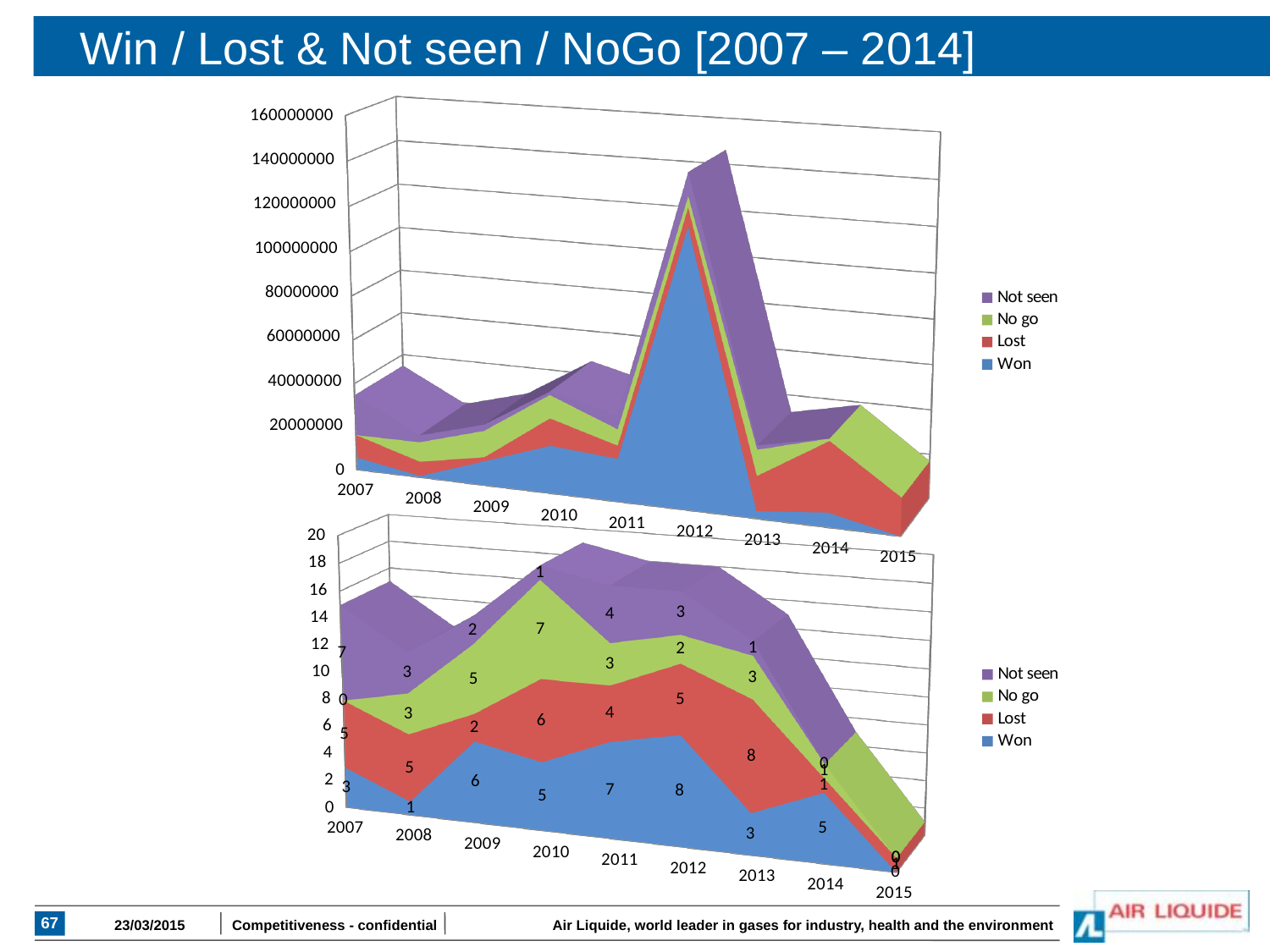
In the bottom chart, what is the value for Lost in 2013? 8 In the bottom chart, what is the value for Won in 2012? 8 In the bottom chart, what is the value for Not seen in 2007? 7 In the bottom chart, what is the value for No go in 2010? 7 In the bottom chart, what is the total of all four series in 2010? 19 How many series does the legend of the top chart list? 4 In the bottom chart, which year has the larger Lost value, 2013 or 2014? 2013 What kind of chart is the top chart? area chart In the top chart, which year has the highest stacked total? 2012 In the bottom chart, what is the difference between the Won value in 2012 and the Won value in 2008? 7 In the bottom chart, which year has the highest Won value? 2012 How many years are shown on the x axis of the bottom chart? 9